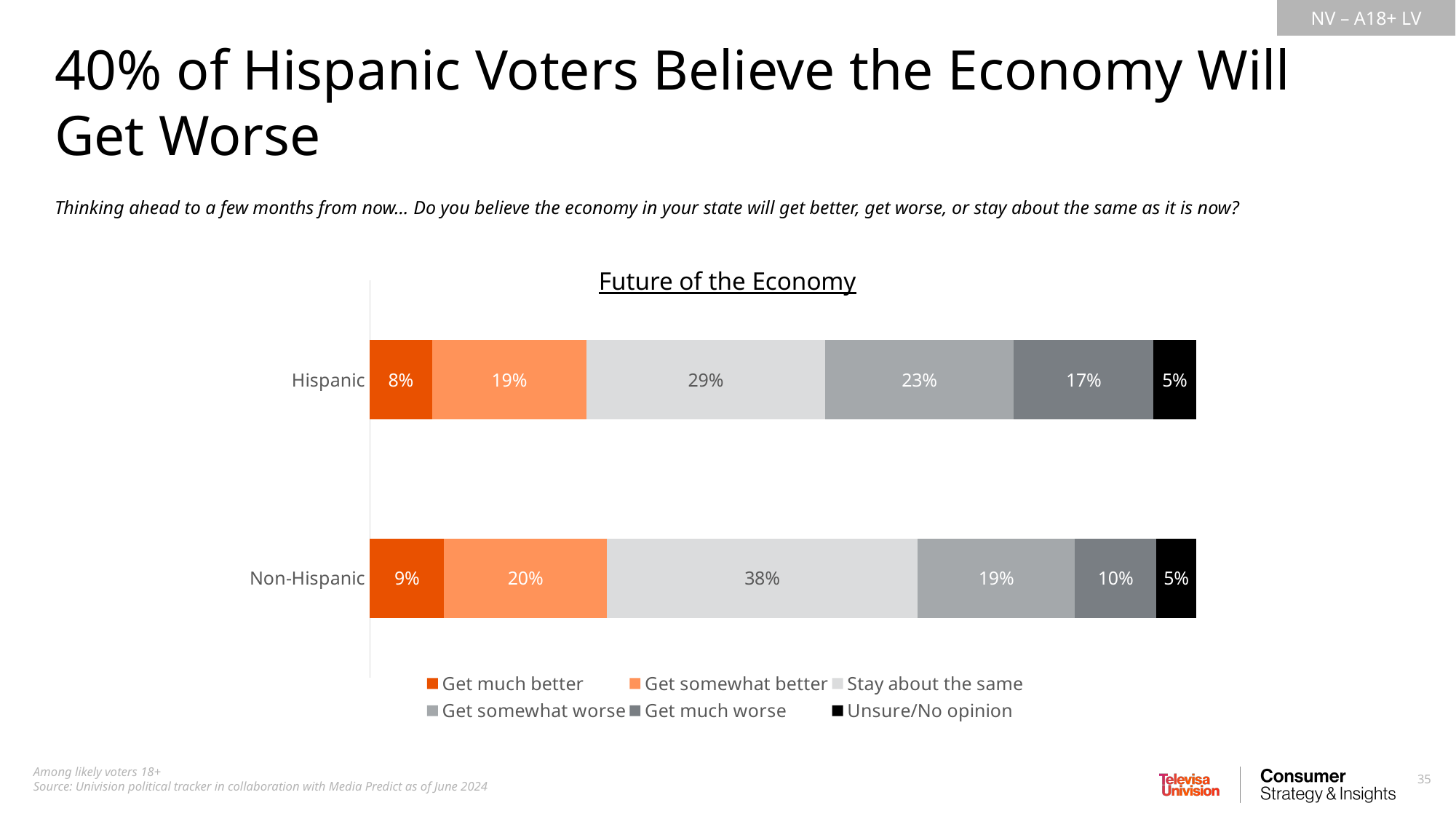
What type of chart is shown on the slide? Stacked bar chart What percentage of Non-Hispanic voters say the economy will get much worse? 10% What is the difference between the Non-Hispanic and Hispanic shares for 'Stay about the same'? 9 percentage points What percentage of Hispanic voters say the economy will get somewhat worse? 23% How many groups (bars) are shown in the chart? 2 What percentage of Non-Hispanic voters say the economy will get somewhat better? 20% How many series does the legend list? 6 Which response has the smallest share among Hispanic voters? Unsure/No opinion What is the combined share of Hispanic voters who say the economy will get somewhat worse or much worse? 40% What percentage of Hispanic voters say the economy will stay about the same? 29% Which response has the largest share among Non-Hispanic voters? Stay about the same Which group has a larger share saying the economy will get much worse, Hispanic or Non-Hispanic? Hispanic